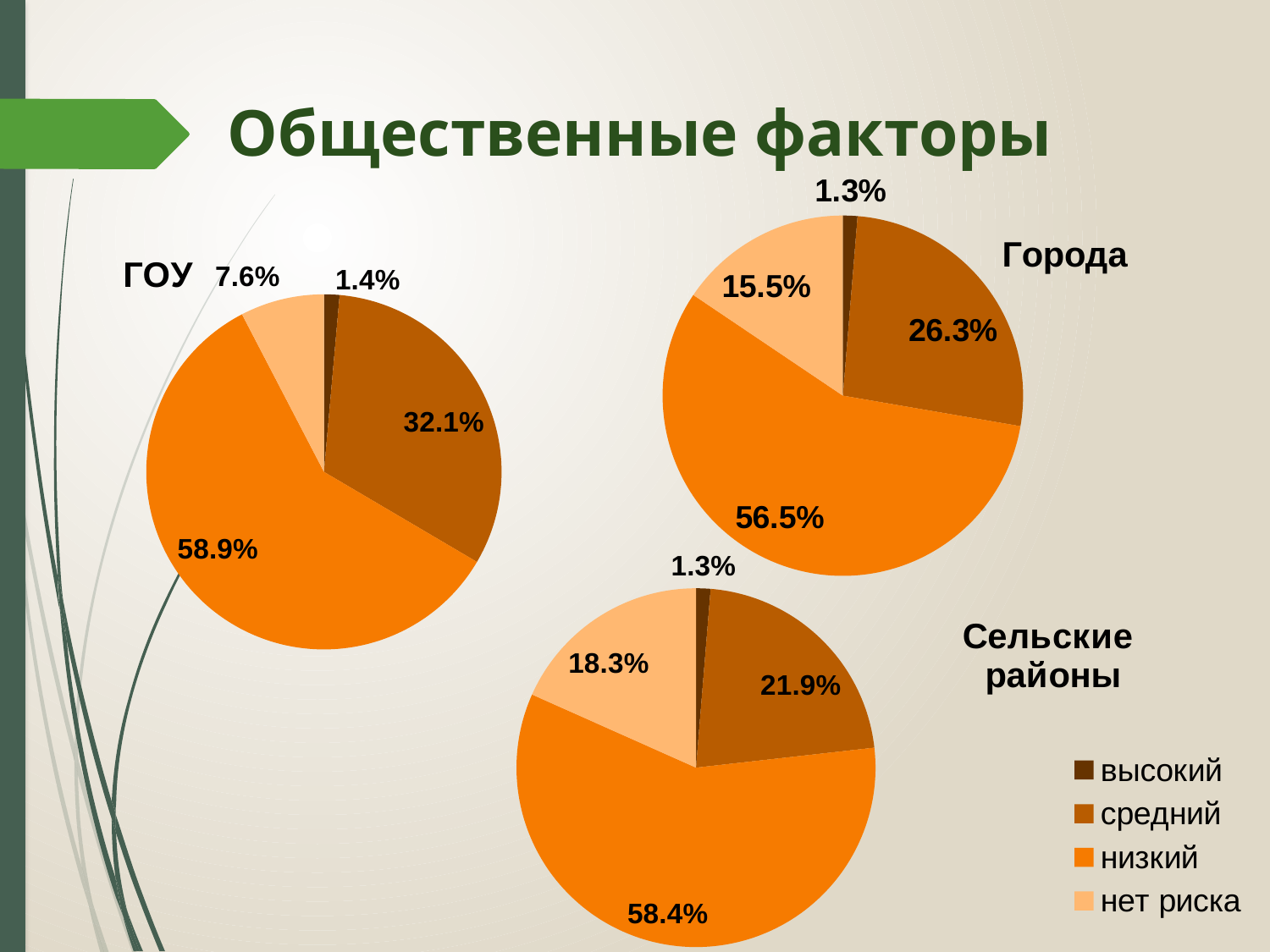
In the ГОУ pie chart, which category has the largest share? низкий In the Города pie chart, what is the share for средний? 26.3% Which is larger: the share for нет риска in the Города pie chart or in the ГОУ pie chart? Города How many slices does the Сельские районы pie chart have? 4 In the Города pie chart, which category has the smallest share? высокий How many pie charts are on the slide? 3 In the Сельские районы pie chart, what is the difference between the shares for низкий and средний? 36.5% In the ГОУ pie chart, what is the share for низкий? 58.9% What kind of chart is the Города chart? pie chart In the Сельские районы pie chart, what is the share for нет риска? 18.3% How many entries does the legend list? 4 What is the title of the slide? Общественные факторы